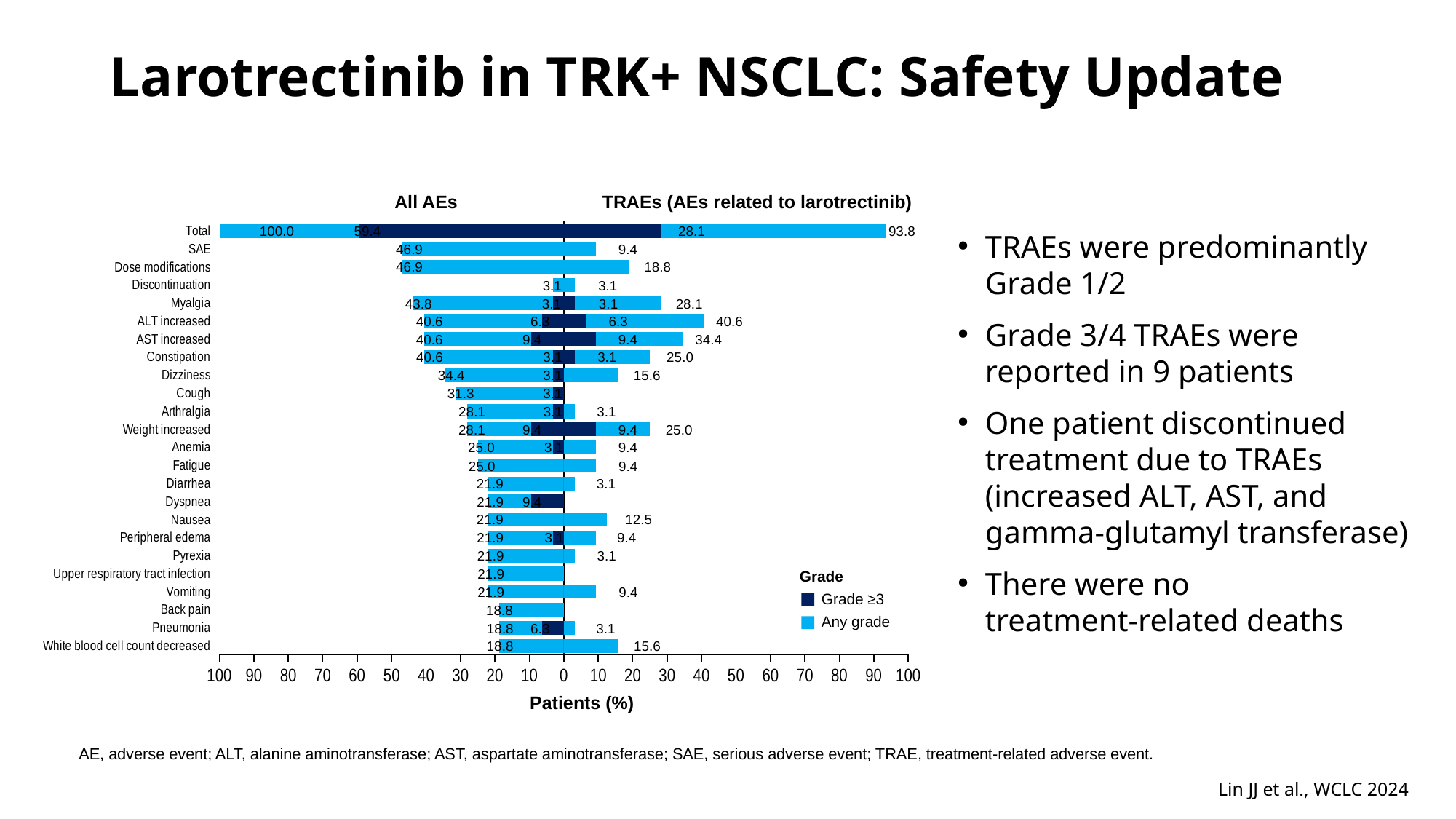
What is the any-grade TRAE value for Dose modifications? 18.8 What is the Grade ≥3 All AEs value for Total? 59.4 How many grade entries does the legend list? 2 What kind of chart is shown on the slide? Bar chart What is the difference between the any-grade All AEs value and the any-grade TRAE value for AST increased? 6.2 What is the any-grade All AEs value for Dizziness? 34.4 How many rows (categories) are listed on the y-axis of the chart? 24 Excluding the Total row, which adverse event has the highest any-grade TRAE value? ALT increased Which is larger, the any-grade TRAE value for Nausea or for Vomiting? Nausea What is the x-axis title of the chart? Patients (%) What is the any-grade TRAE value for ALT increased? 40.6 What is the any-grade TRAE value for White blood cell count decreased? 15.6